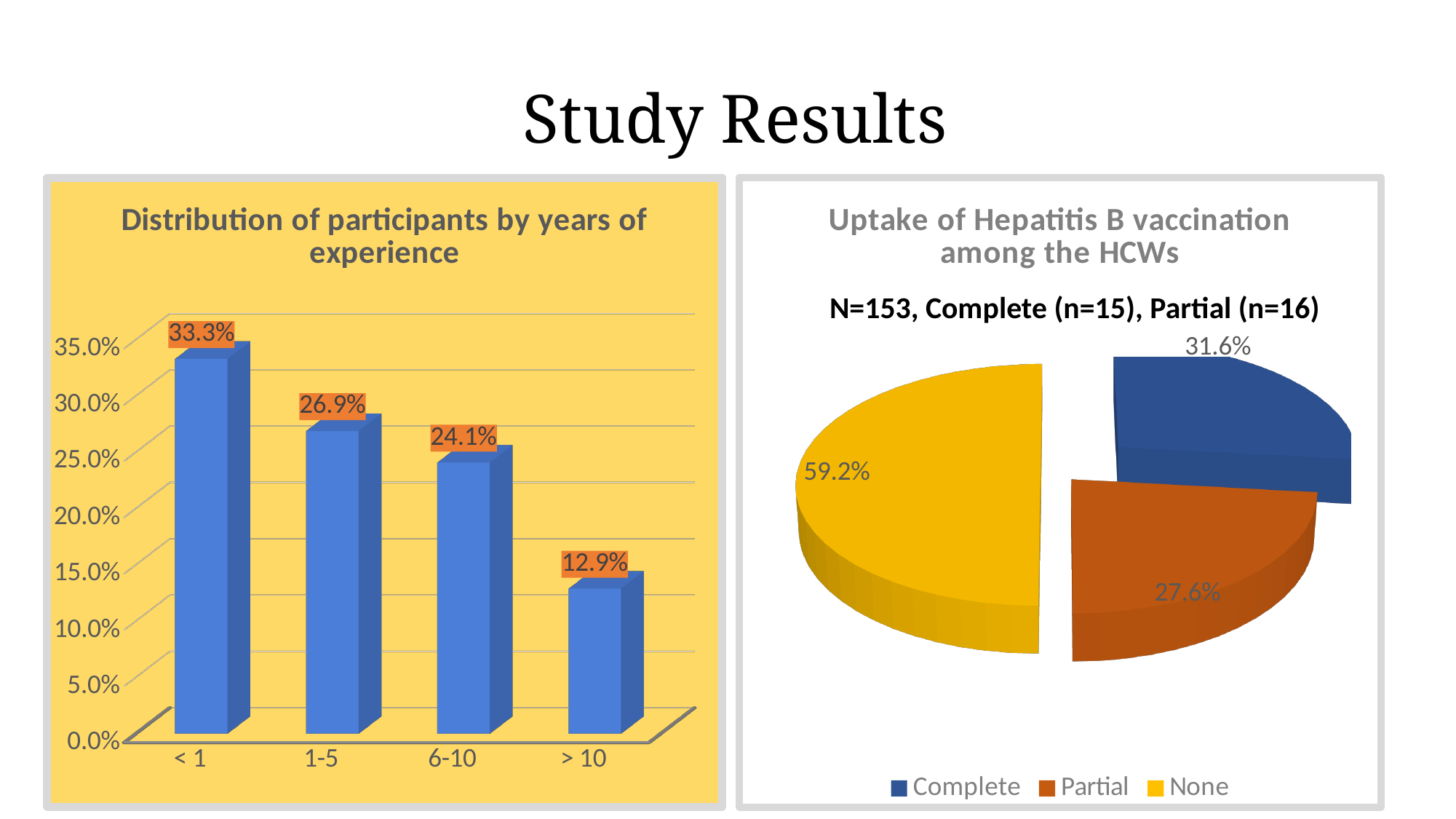
In the 'Uptake of Hepatitis B vaccination among the HCWs' chart, which slice is the largest? None In the 'Distribution of participants by years of experience' chart, what is the difference between the '< 1' and '6-10' values? 9.2% In the 'Uptake of Hepatitis B vaccination among the HCWs' chart, what share of the pie is 'Partial'? 27.6% In the 'Uptake of Hepatitis B vaccination among the HCWs' chart, which is larger, 'Complete' or 'Partial'? Complete In the 'Distribution of participants by years of experience' chart, what is the value for the '> 10' category? 12.9% In the 'Distribution of participants by years of experience' chart, how many categories are shown on the x axis? 4 In the 'Distribution of participants by years of experience' chart, which category has the lowest value? > 10 In the 'Distribution of participants by years of experience' chart, which category has the highest value? < 1 What kind of chart is 'Distribution of participants by years of experience'? bar chart In the 'Distribution of participants by years of experience' chart, what is the value for the '1-5' category? 26.9% In the 'Distribution of participants by years of experience' chart, do the values rise or fall from left to right along the x axis? fall How many entries does the legend of the 'Uptake of Hepatitis B vaccination among the HCWs' chart list? 3